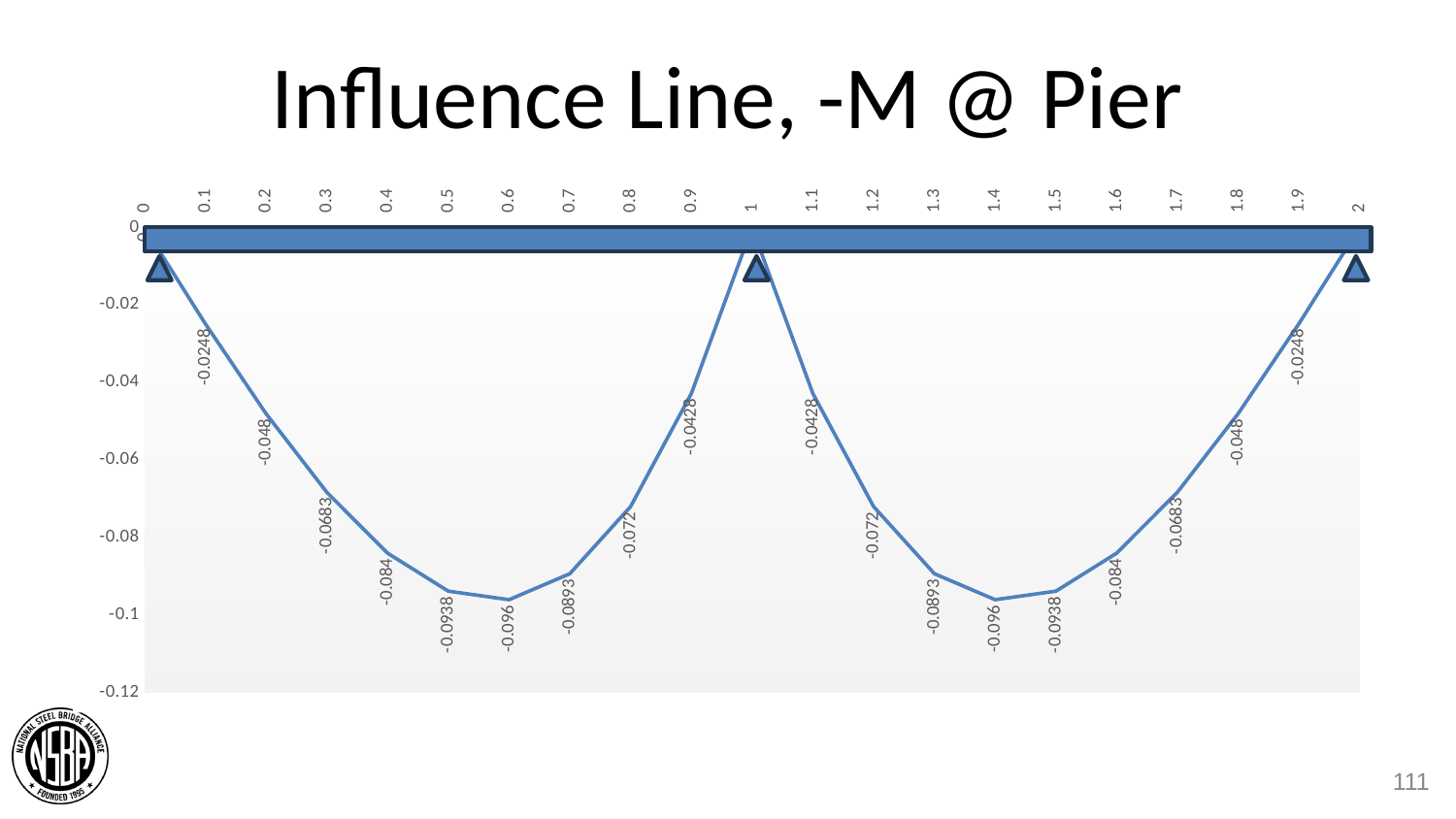
What is the value plotted at x = 0.6? -0.096 What is the value plotted at x = 1.9? -0.0248 What is the difference between the values at x = 0.2 and x = 0.4? 0.036 What is the value plotted at x = 1.2? -0.072 What is the lowest (most negative) labelled value on the chart? -0.096 What type of chart is shown on the slide? Line chart Which has the larger magnitude, the value at x = 0.8 or the value at x = 0.9? x = 0.8 What is the value plotted at x = 1.5? -0.0938 What is the value plotted at x = 0.3? -0.0683 What is the title of the slide? Influence Line, -M @ Pier What is the difference between the values at x = 0.5 and x = 0.6? 0.0022 Is the value at x = 0.7 greater or less than -0.08? less